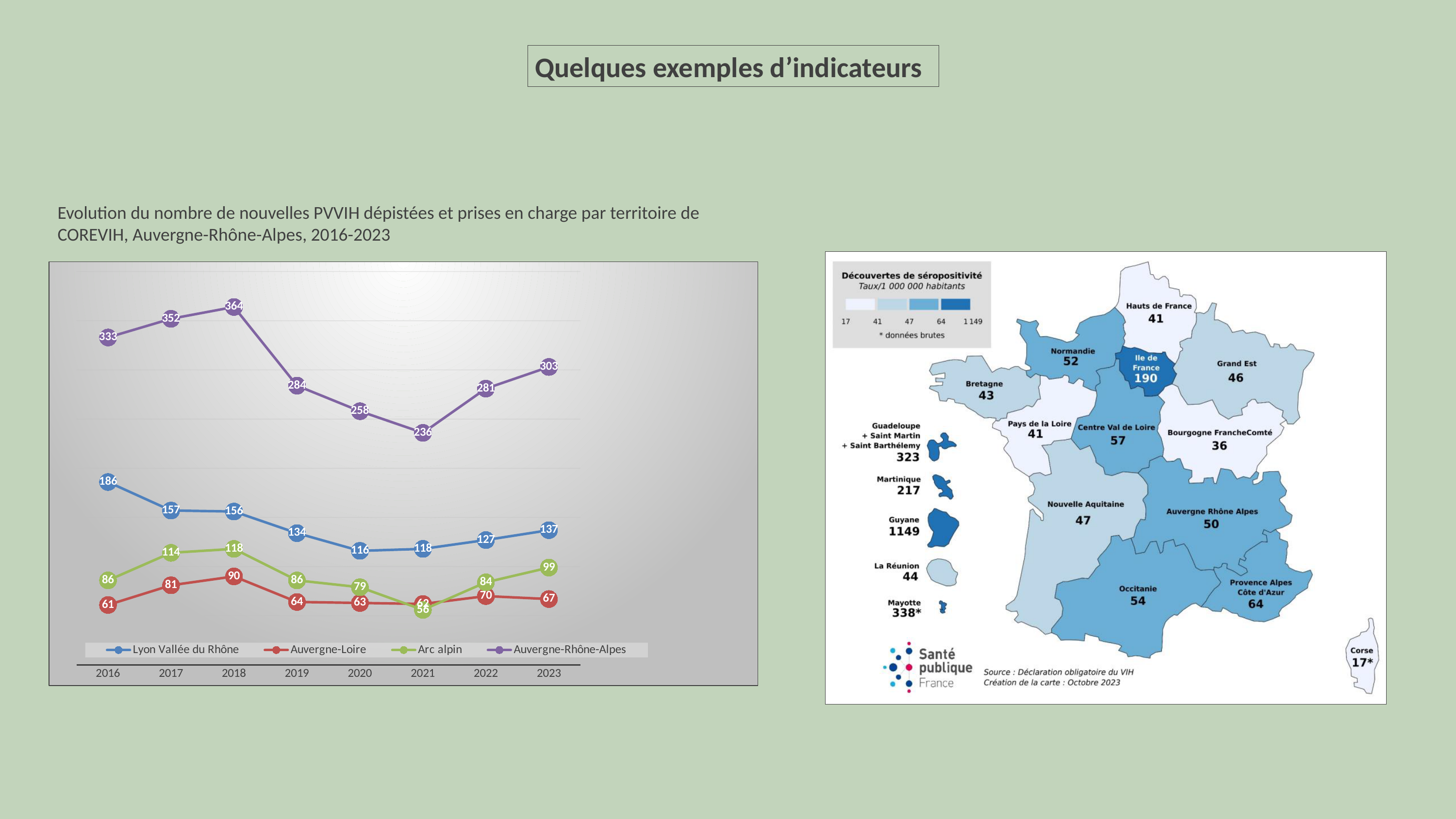
In the line chart on the left, what is the value for Auvergne-Rhône-Alpes in 2018? 364 How many series does the legend of the line chart on the left list? 4 In the line chart on the left, in which year does the Lyon Vallée du Rhône series reach its lowest value? 2020 In the line chart on the left, what is the value for Auvergne-Loire in 2017? 81 In the line chart on the left, what is the difference between the Auvergne-Rhône-Alpes values in 2018 and 2021? 128 How many years are shown on the x axis of the line chart on the left? 8 In the line chart on the left, what is the value for Arc alpin in 2023? 99 What kind of chart is shown on the left of the slide? Line chart In the line chart on the left, what is the value for Lyon Vallée du Rhône in 2020? 116 In the line chart on the left, which series has the larger value in 2019: Arc alpin or Auvergne-Loire? Arc alpin In the line chart on the left, in which year does the Auvergne-Rhône-Alpes series reach its highest value? 2018 In the line chart on the left, does the Lyon Vallée du Rhône series rise or fall from 2016 to 2020? Fall